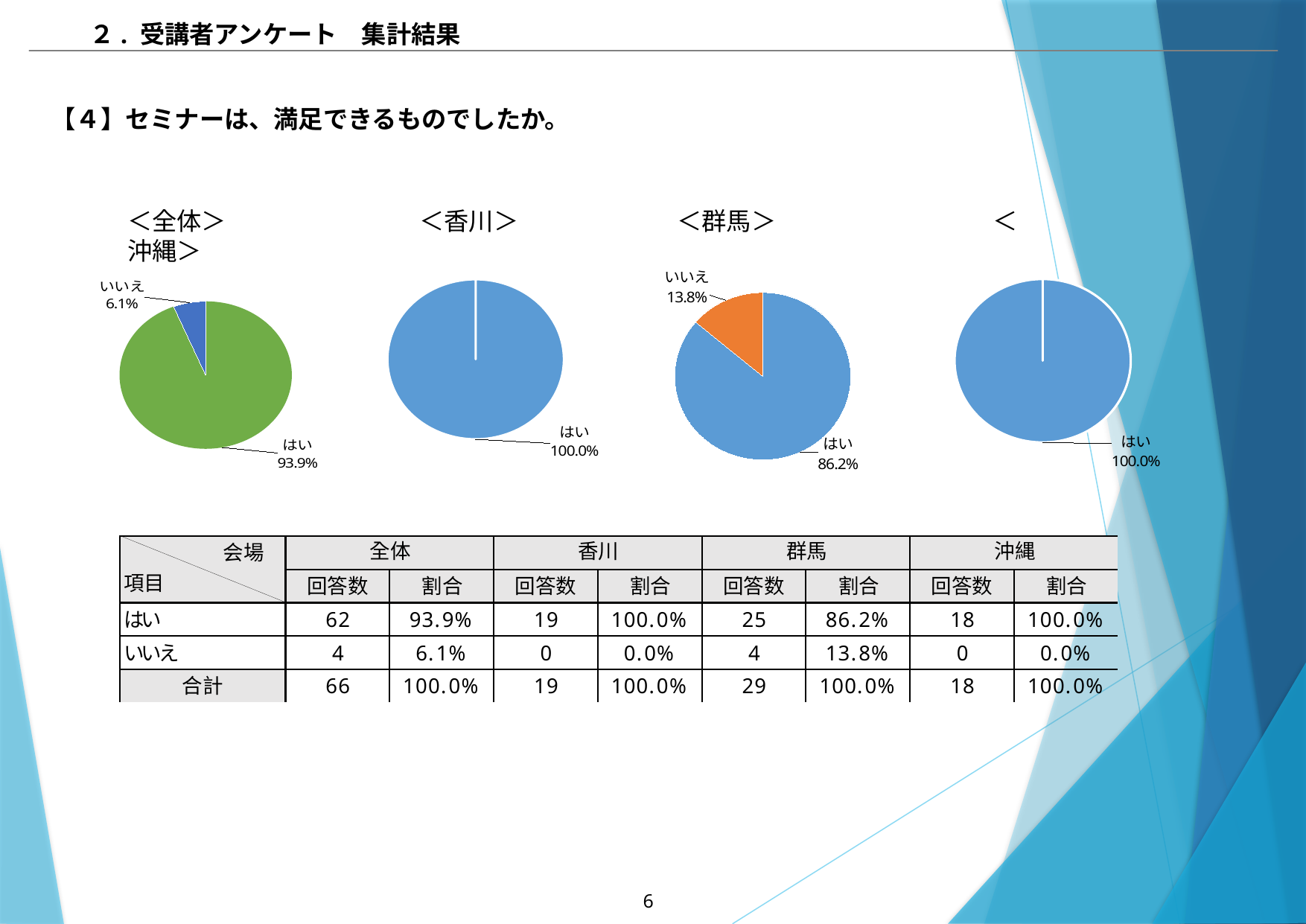
In the <全体> pie chart, what share is labelled for はい? 93.9% In the <全体> pie chart, which slice is the smallest? いいえ In the <群馬> pie chart, what share is labelled for はい? 86.2% What kind of chart is used for <香川>? Pie chart In the <群馬> pie chart, what share is labelled for いいえ? 13.8% In the <群馬> pie chart, what is the difference between the はい share and the いいえ share? 72.4% In the <全体> pie chart, what share is labelled for いいえ? 6.1% In the <香川> pie chart, what share is labelled for はい? 100.0% Which is larger: the いいえ share in the <群馬> pie chart or the いいえ share in the <全体> pie chart? 群馬 How many pie charts are shown on the slide? 4 In the <群馬> pie chart, what colour is the いいえ slice? Orange In the <群馬> pie chart, which slice is the largest? はい